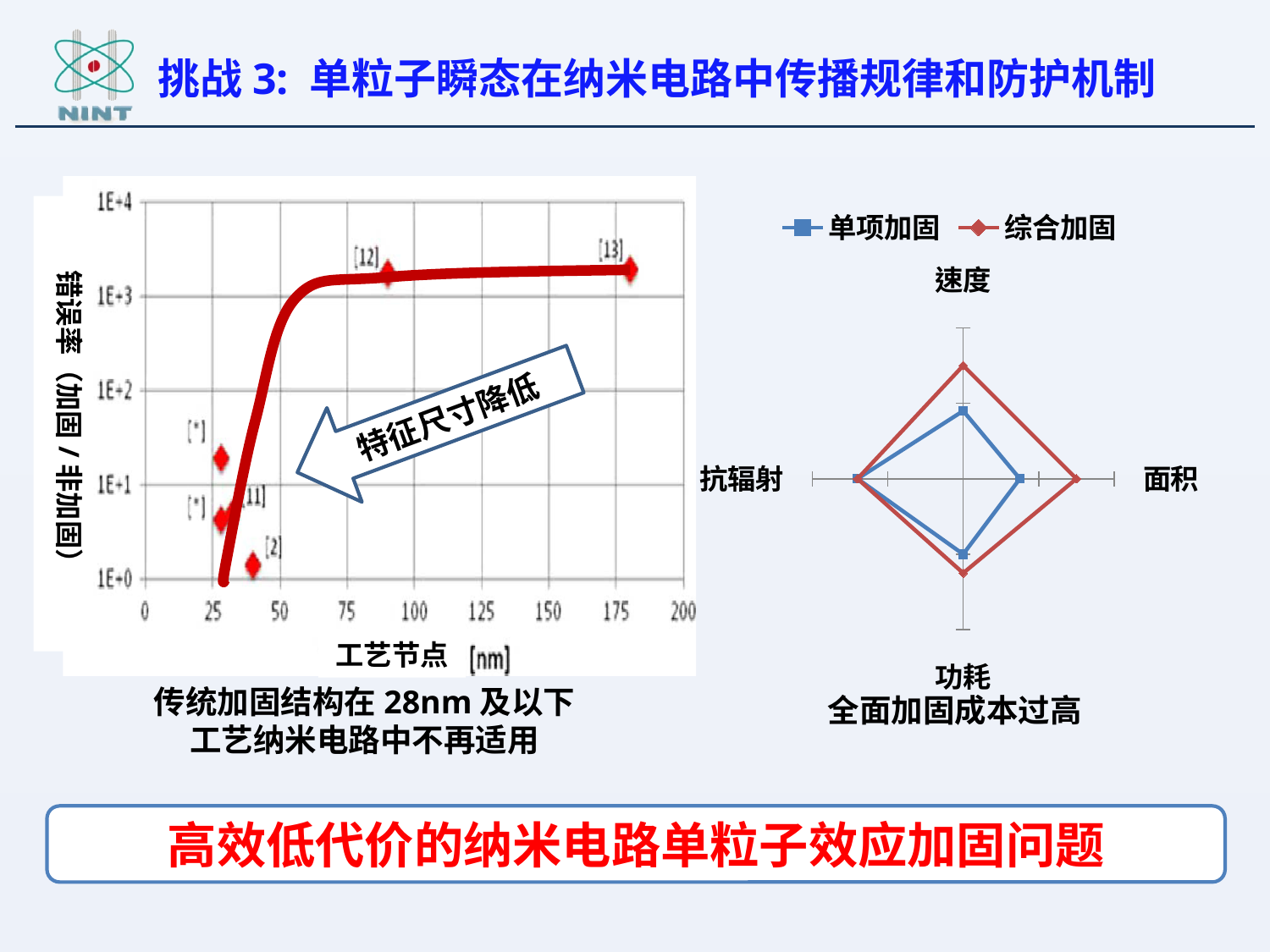
On the left chart, which labelled point has the lowest error rate? [2] On the right chart, what kind of chart is it? radar chart On the left chart, is the value for the point labelled [12] greater or less than 1E+2? greater On the right radar chart, how many series does the legend list? 2 On the right radar chart, how many axes (categories) are there? 4 On the left chart, is the value for the point labelled [13] greater or less than 1E+3? greater On the left chart, do the plotted values rise or fall as the process node (工艺节点) increases along the x axis? rise On the left chart, what is the x-axis label? 工艺节点 [nm] On the left chart, is the value for the point labelled [2] greater or less than 1E+1? less On the left chart, what kind of chart is it? scatter chart On the right radar chart, which series has the larger value for 速度, 单项加固 or 综合加固? 综合加固